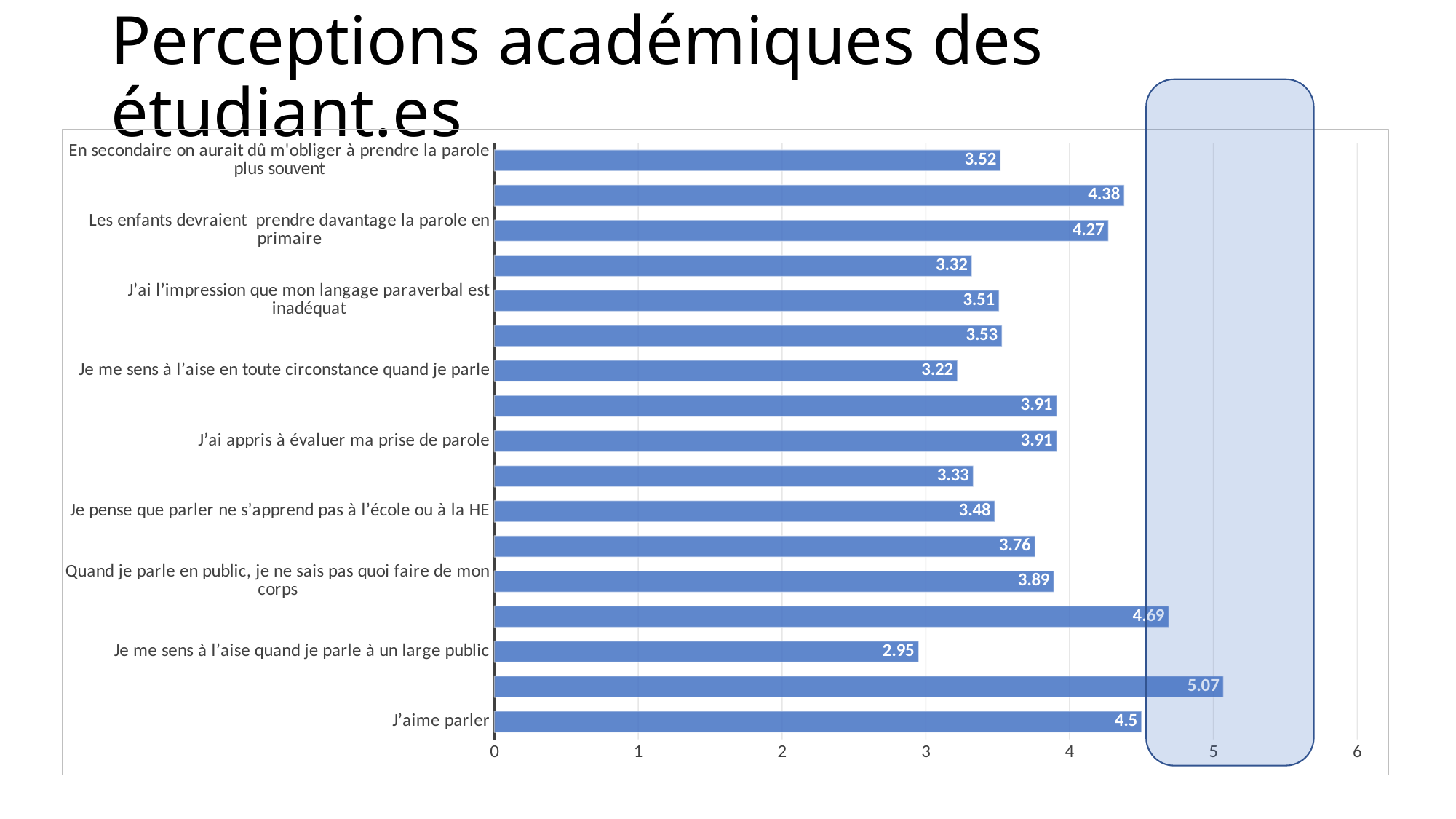
What is the value for "J'ai appris à évaluer ma prise de parole"? 3.91 What is the value for "Je pense que parler ne s'apprend pas à l'école ou à la HE"? 3.48 What type of chart is shown on the slide? bar chart What is the value for "J'aime parler"? 4.5 Which labelled category has the lowest value? Je me sens à l'aise quand je parle à un large public What is the title of the slide? Perceptions académiques des étudiant.es What is the value for "Les enfants devraient prendre davantage la parole en primaire"? 4.27 What is the value for "Je me sens à l'aise quand je parle à un large public"? 2.95 What is the difference between the values for "J'aime parler" and "Je me sens à l'aise quand je parle à un large public"? 1.55 Which is larger: the value for "Les enfants devraient prendre davantage la parole en primaire" or for "En secondaire on aurait dû m'obliger à prendre la parole plus souvent"? Les enfants devraient prendre davantage la parole en primaire How many bars are plotted in the chart? 17 What is the highest value shown on any bar in the chart? 5.07